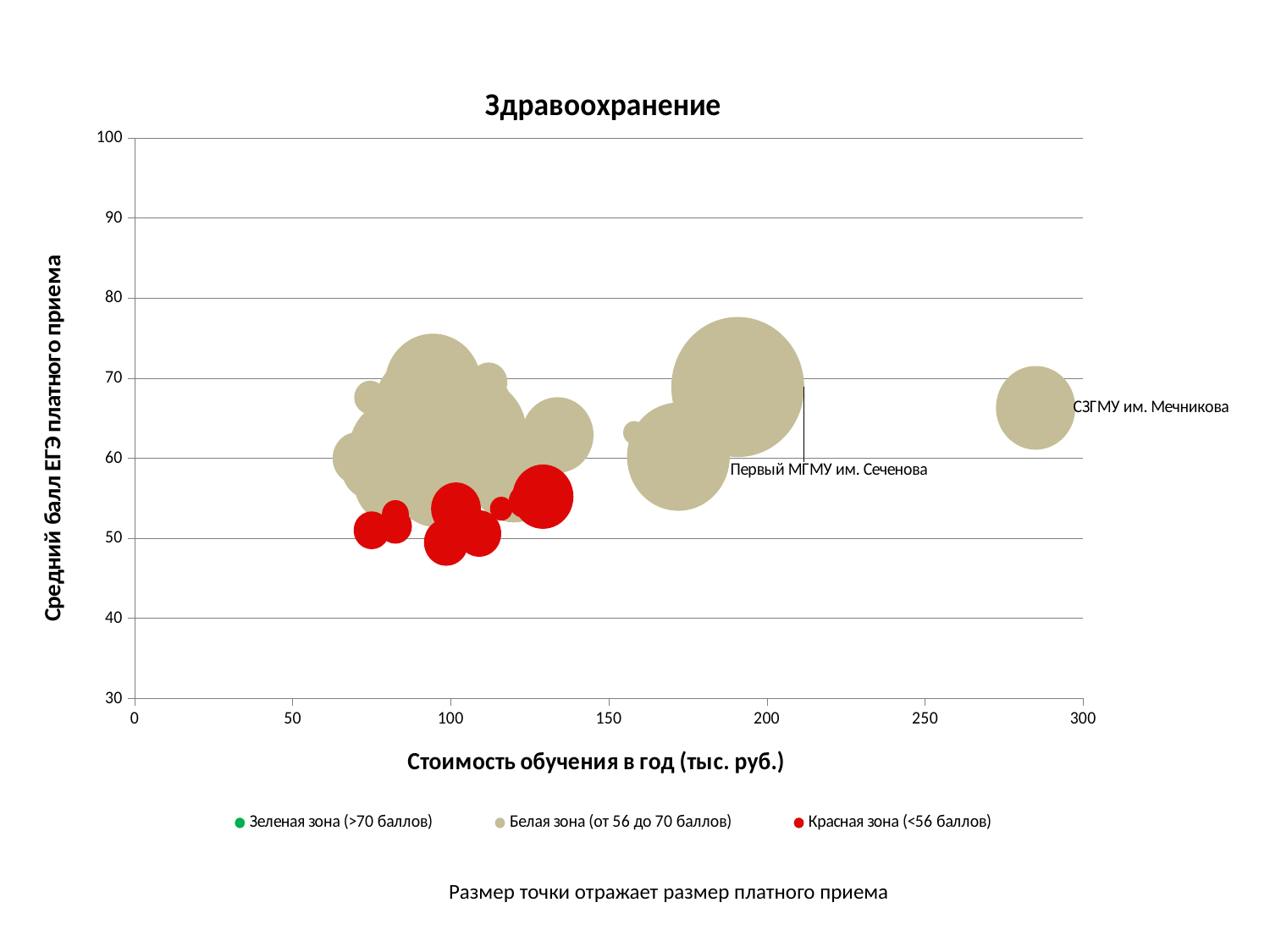
Is the tuition cost (x value) for Первый МГМУ им. Сеченова greater or less than 150? greater Which legend series is shown in red? Красная зона (<56 баллов) Is the tuition cost (x value) for СЗГМУ им. Мечникова greater or less than 250? greater Is the average exam score (y value) for Первый МГМУ им. Сеченова greater or less than 80? less What does the x axis of the chart represent? Стоимость обучения в год (тыс. руб.) What is the title of the chart? Здравоохранение Which of the two labeled universities has the higher tuition cost (x value): СЗГМУ им. Мечникова or Первый МГМУ им. Сеченова? СЗГМУ им. Мечникова How many series does the legend list? 3 What type of chart is shown on the slide? Bubble chart